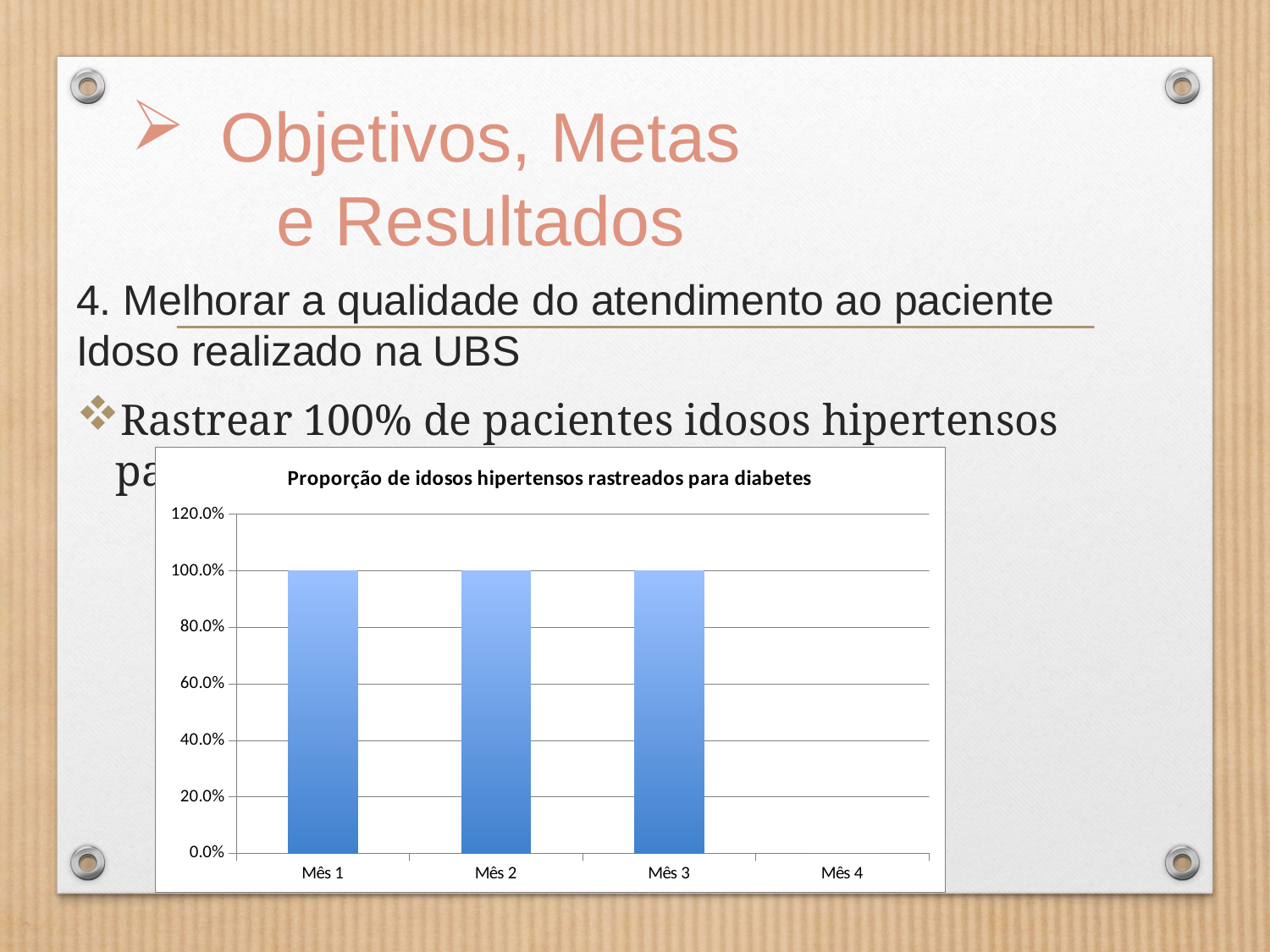
Which is larger, the value for Mês 1 or the value for Mês 4? Mês 1 How many months (categories) are shown on the x axis of the chart? 4 What is the difference between the values for Mês 3 and Mês 4? 100.0% What is the value for Mês 2? 100.0% Is the value for Mês 2 greater or less than 80.0%? greater What is the value for Mês 1? 100.0% What is the title of the chart? Proporção de idosos hipertensos rastreados para diabetes Do the values rise or fall from Mês 3 to Mês 4? fall Which month has the lowest value? Mês 4 What is the value for Mês 3? 100.0% What is the value for Mês 4? 0.0% What kind of chart is shown on the slide? bar chart